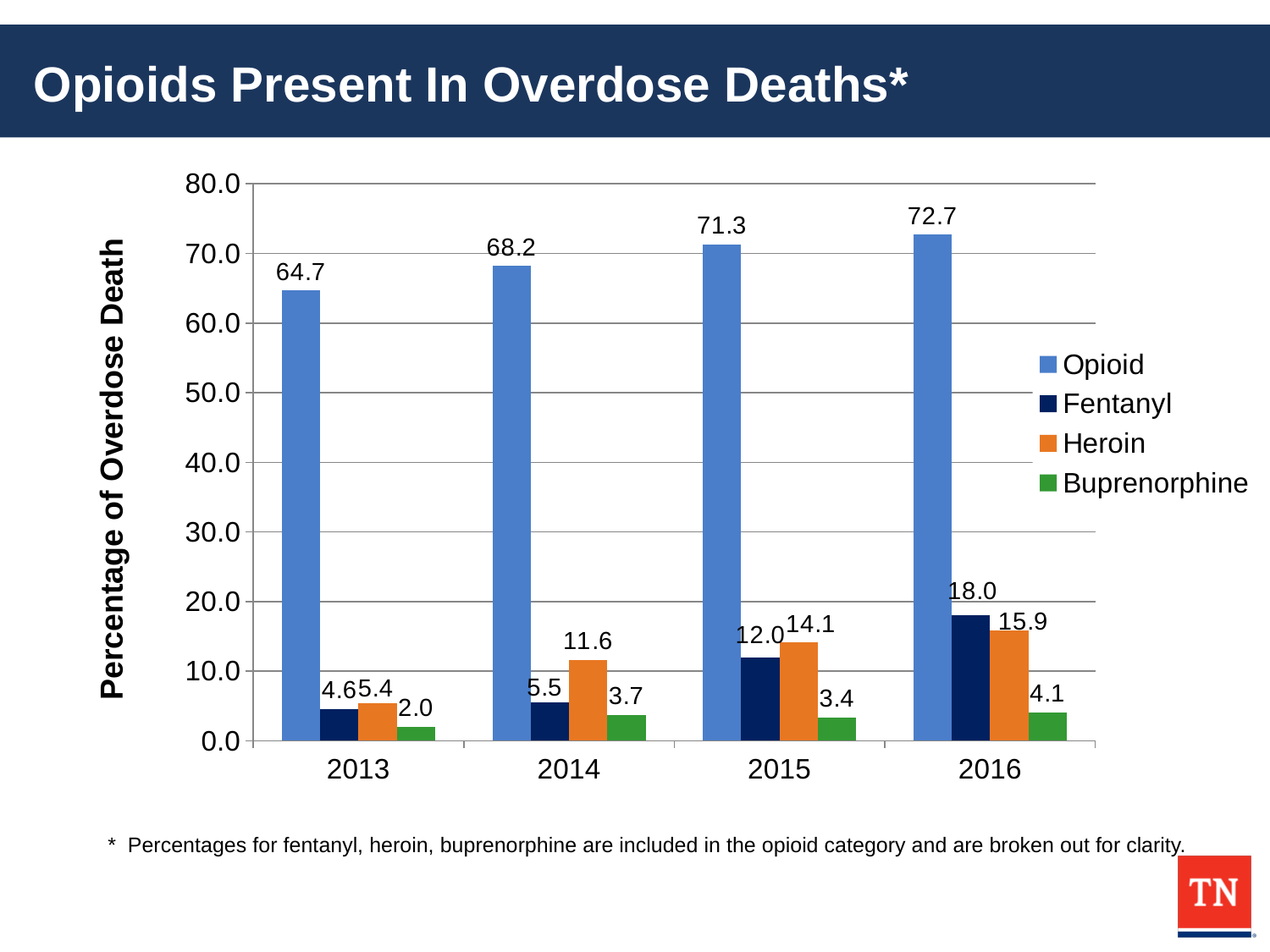
In which year is the Fentanyl value lowest? 2013 What is the Opioid value for 2016? 72.7 Does the Opioid value rise or fall from 2013 to 2016? Rise Which is larger in 2016, the Fentanyl value or the Heroin value? Fentanyl What is the Buprenorphine value for 2013? 2.0 How many years are shown on the x axis? 4 What is the Heroin value for 2014? 11.6 What kind of chart is shown on the slide? Bar chart What is the difference between the Opioid values for 2016 and 2013? 8.0 In which year is the Opioid value highest? 2016 What is the Fentanyl value for 2015? 12.0 How many series does the legend list? 4